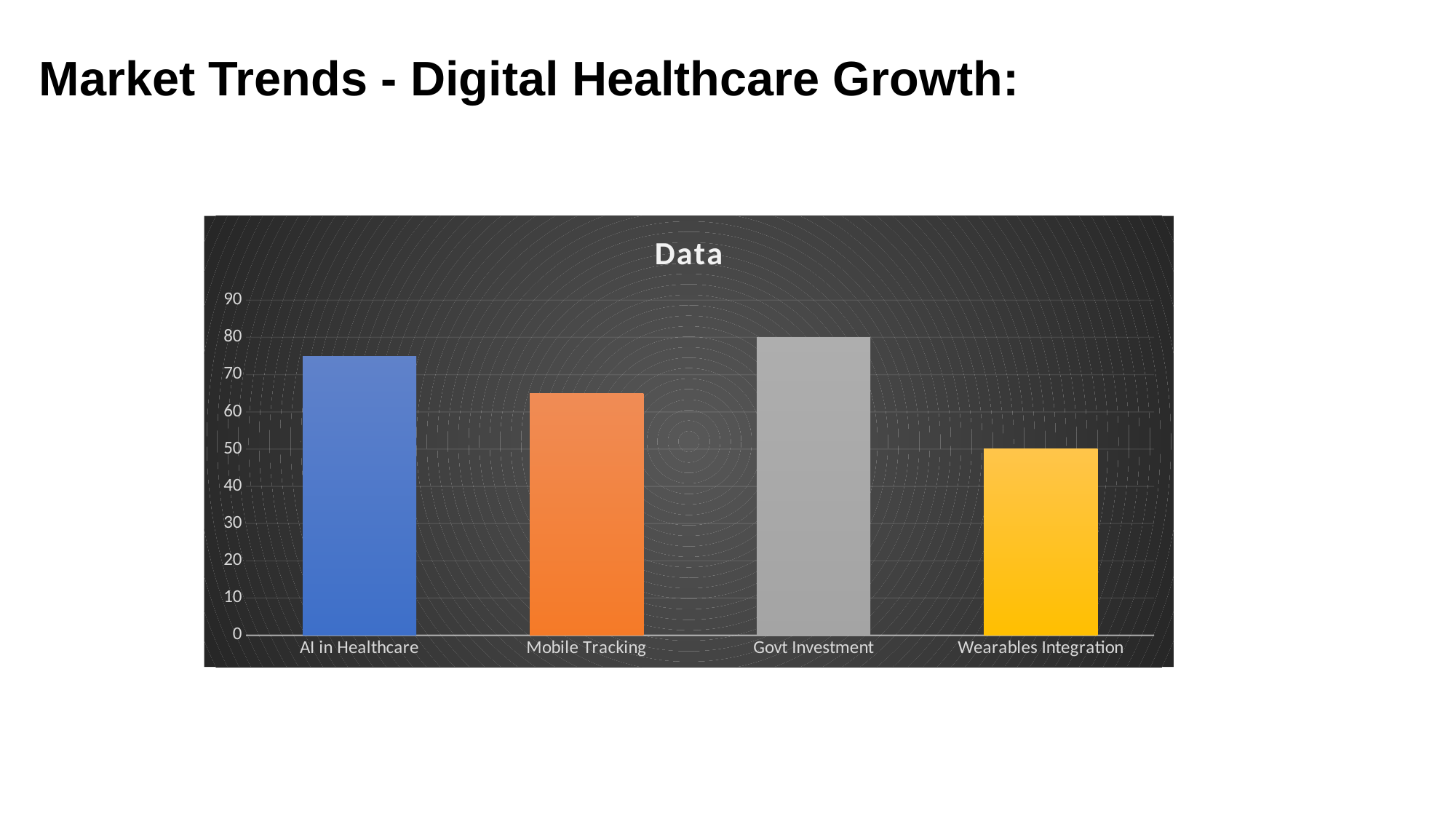
What is the difference between the values for Govt Investment and Wearables Integration? 30 What is the value for Govt Investment? 80 Is the value for Mobile Tracking greater or less than 70? less Which category has the highest bar? Govt Investment What is the value for Wearables Integration? 50 What colour is the bar for Mobile Tracking? orange Which is larger, the value for AI in Healthcare or the value for Mobile Tracking? AI in Healthcare Is the value for AI in Healthcare greater or less than 70? greater How many categories are shown on the x axis of the chart? 4 Which category has the lowest bar? Wearables Integration What is the title of the chart? Data What kind of chart is shown on the slide? bar chart